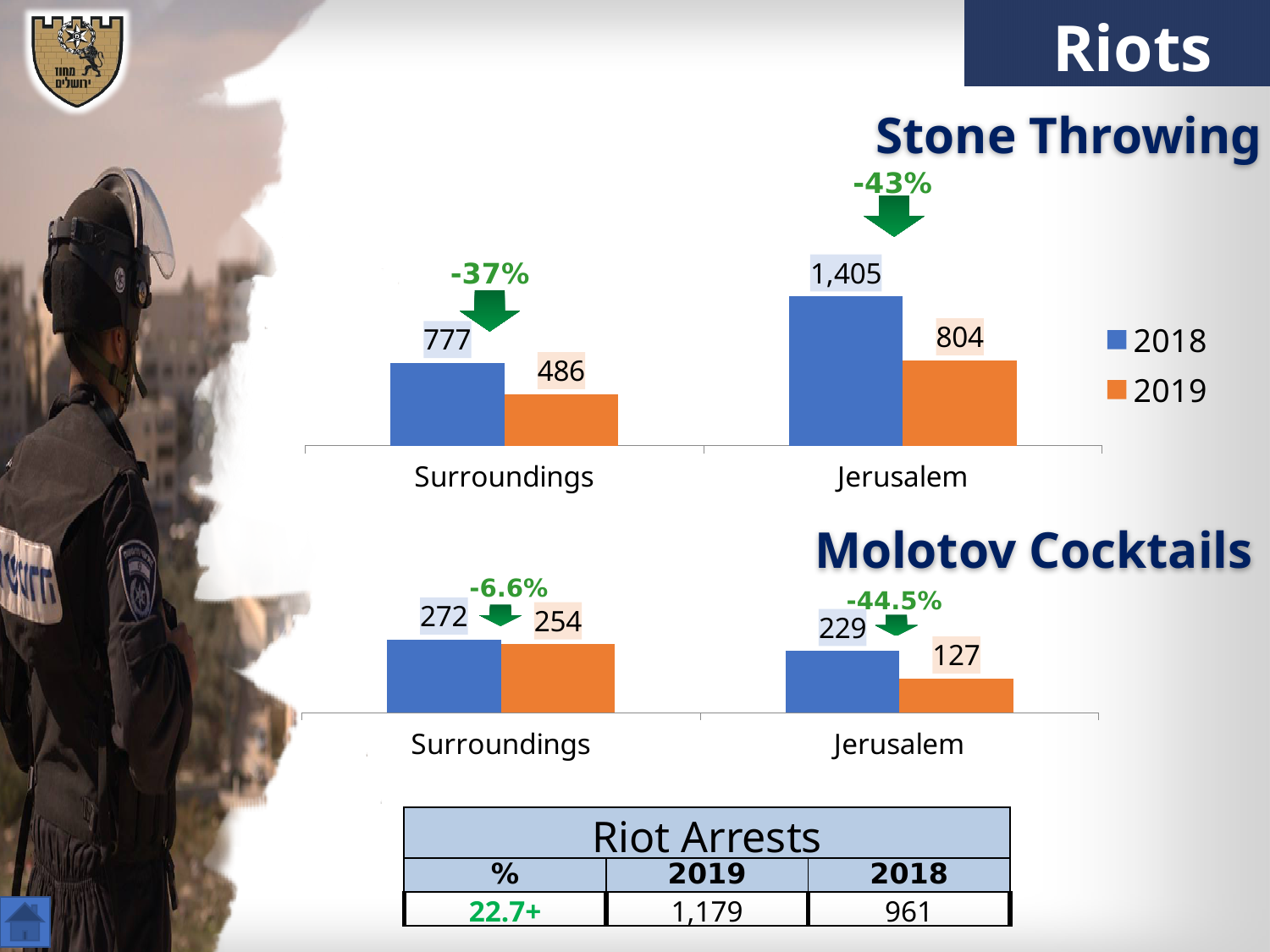
In the Molotov Cocktails chart, what is the value for Jerusalem in 2019? 127 In the Stone Throwing chart, is the 2019 value for Jerusalem larger or smaller than the 2018 value for Surroundings? larger In the Molotov Cocktails chart, what is the difference between the 2018 and 2019 values for Jerusalem? 102 In the Stone Throwing chart, which category has the highest 2018 value? Jerusalem In the Stone Throwing chart, what is the value for Surroundings in 2019? 486 In the Stone Throwing chart, what is the value for Jerusalem in 2018? 1,405 In the Molotov Cocktails chart, what is the value for Surroundings in 2018? 272 In the Molotov Cocktails chart, which category has the lowest 2019 value? Jerusalem In the Stone Throwing chart, what is the difference between the 2018 and 2019 values for Surroundings? 291 What kind of chart is the Stone Throwing chart? bar chart How many series does the legend list for the Stone Throwing chart? 2 How many categories are shown on the x axis of the Molotov Cocktails chart? 2